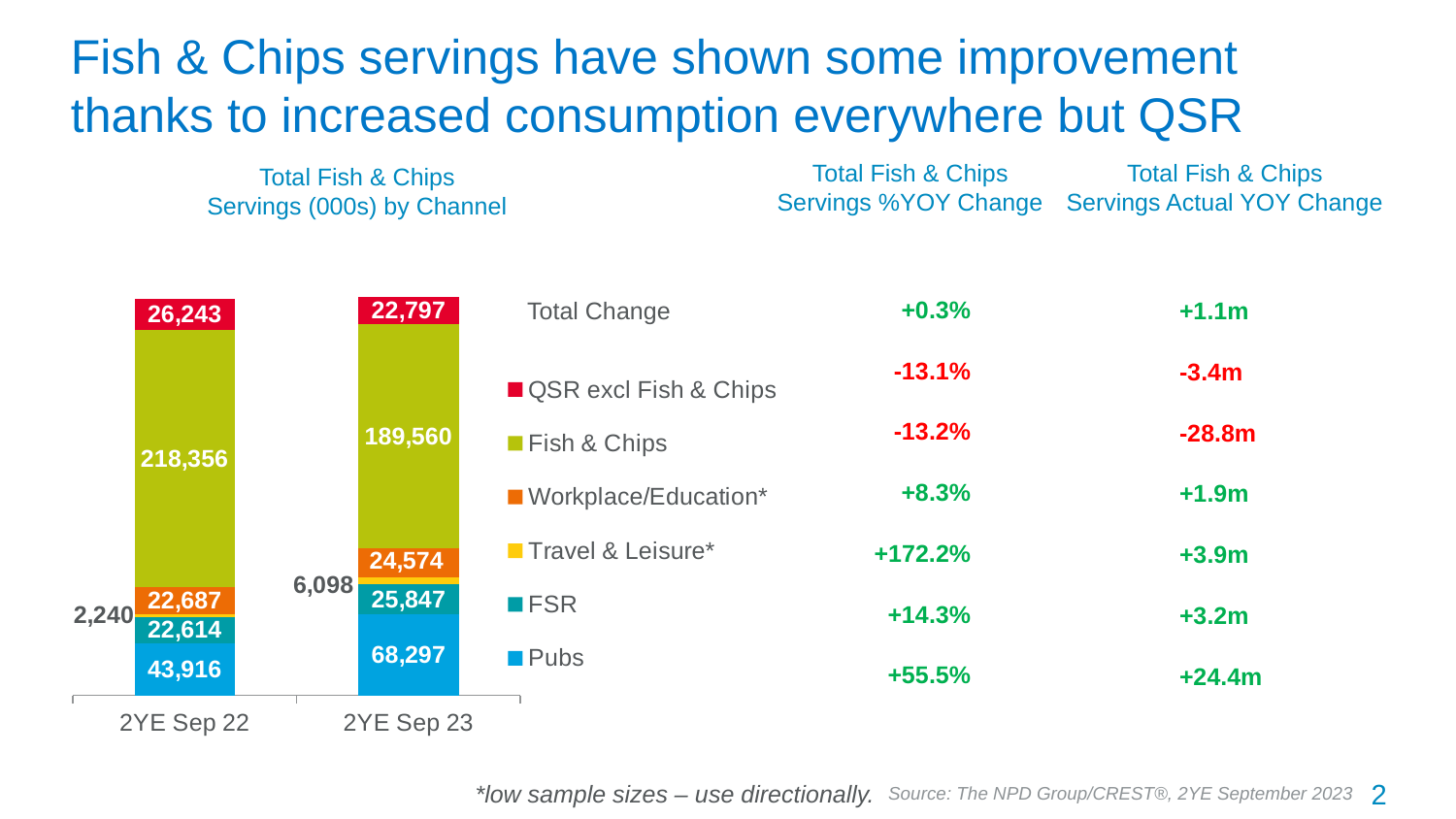
What type of chart is shown on the slide? Stacked bar chart By how much did the Pubs value increase from 2YE Sep 22 to 2YE Sep 23? 24,381 What is the value for QSR excl Fish & Chips in 2YE Sep 22? 26,243 What is the value for Travel & Leisure* in 2YE Sep 23? 6,098 How many bars (time periods) are plotted on the x axis? 2 Is the FSR value larger in 2YE Sep 22 or 2YE Sep 23? 2YE Sep 23 Which channel has the largest segment in the 2YE Sep 23 bar? Fish & Chips What is the total of the 2YE Sep 23 stacked bar? 337,173 Which channel has the smallest segment in the 2YE Sep 22 bar? Travel & Leisure* What is the value for Pubs in 2YE Sep 23? 68,297 What is the value for Fish & Chips in 2YE Sep 22? 218,356 How many series does the chart legend list? 6